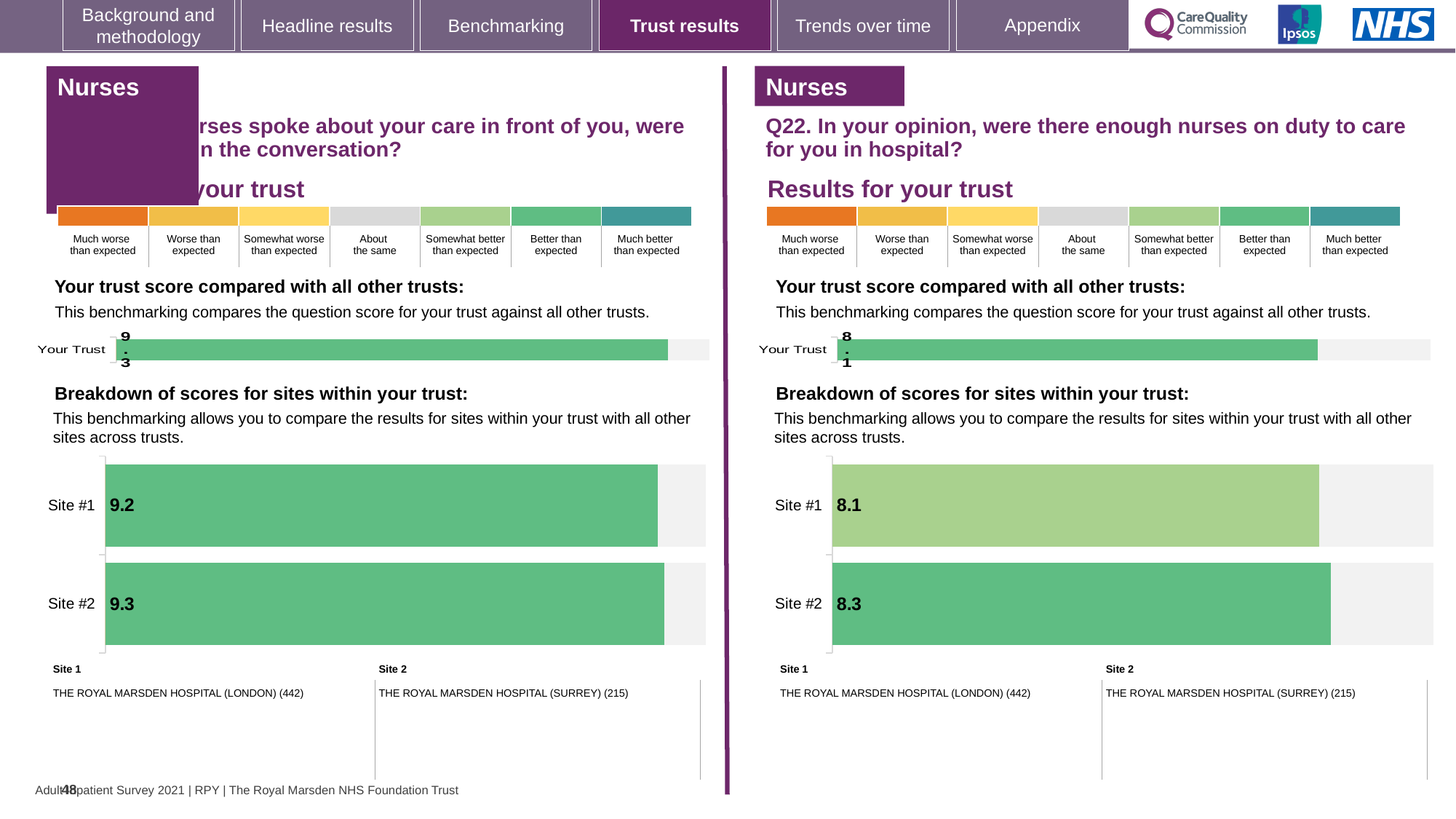
In the left panel's site breakdown chart, what is the score for Site #1? 9.2 How many sites are shown in the right panel (Q22) site breakdown chart? 2 What type of chart is used for the site breakdown in the left panel? Bar chart In the right panel (Q22) 'Your Trust' chart, what is the trust score shown? 8.1 In the right panel (Q22) site breakdown chart, what is the difference between the Site #2 and Site #1 scores? 0.2 In the right panel (Q22) site breakdown chart, which site has the higher score? Site #2 In the left panel's site breakdown chart, what is the difference between the Site #2 and Site #1 scores? 0.1 In the left panel 'Your Trust' chart, what is the trust score shown? 9.3 In the right panel (Q22) site breakdown chart, what is the score for Site #1? 8.1 In the right panel (Q22) site breakdown chart, what is the score for Site #2? 8.3 In the left panel's site breakdown chart, what is the score for Site #2? 9.3 In the right panel (Q22) site breakdown chart, is the Site #1 bar a lighter or darker green than the Site #2 bar? Lighter